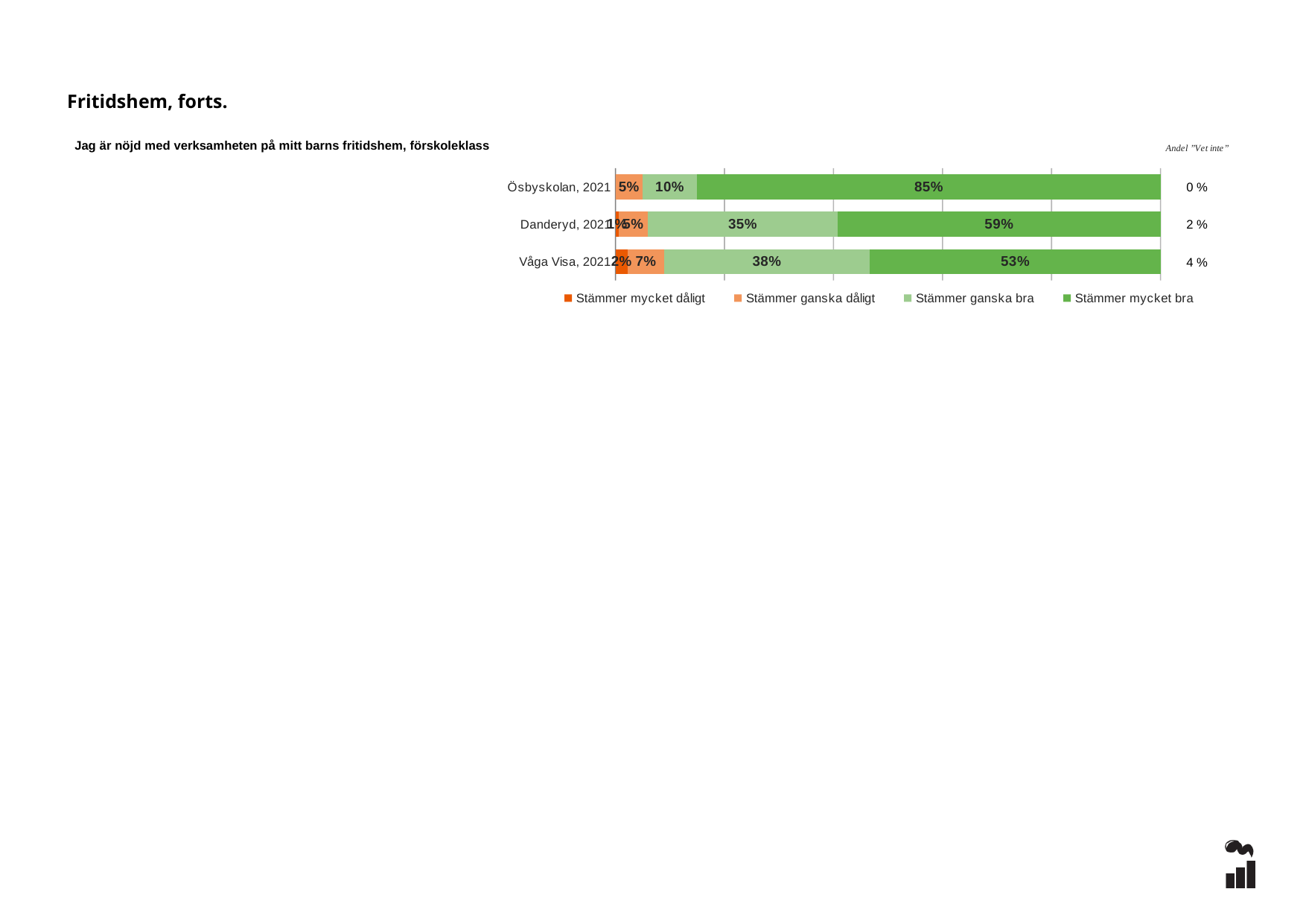
What kind of chart is shown on the slide? Stacked bar chart What is the value for "Stämmer ganska dåligt" for Våga Visa, 2021? 7% What is the value for "Stämmer mycket bra" for Våga Visa, 2021? 53% Which category has the lowest value for "Stämmer ganska bra"? Ösbyskolan, 2021 How many series does the legend list? 4 How many categories are shown in the chart? 3 What is the difference between the "Stämmer mycket bra" values for Ösbyskolan, 2021 and Våga Visa, 2021? 32 percentage points What is the "Andel Vet inte" share shown for Våga Visa, 2021? 4 % What is the value for "Stämmer mycket bra" for Ösbyskolan, 2021? 85% What is the value for "Stämmer ganska bra" for Danderyd, 2021? 35% Which category has the highest value for "Stämmer mycket bra"? Ösbyskolan, 2021 Which has the larger "Stämmer ganska bra" value, Danderyd, 2021 or Våga Visa, 2021? Våga Visa, 2021